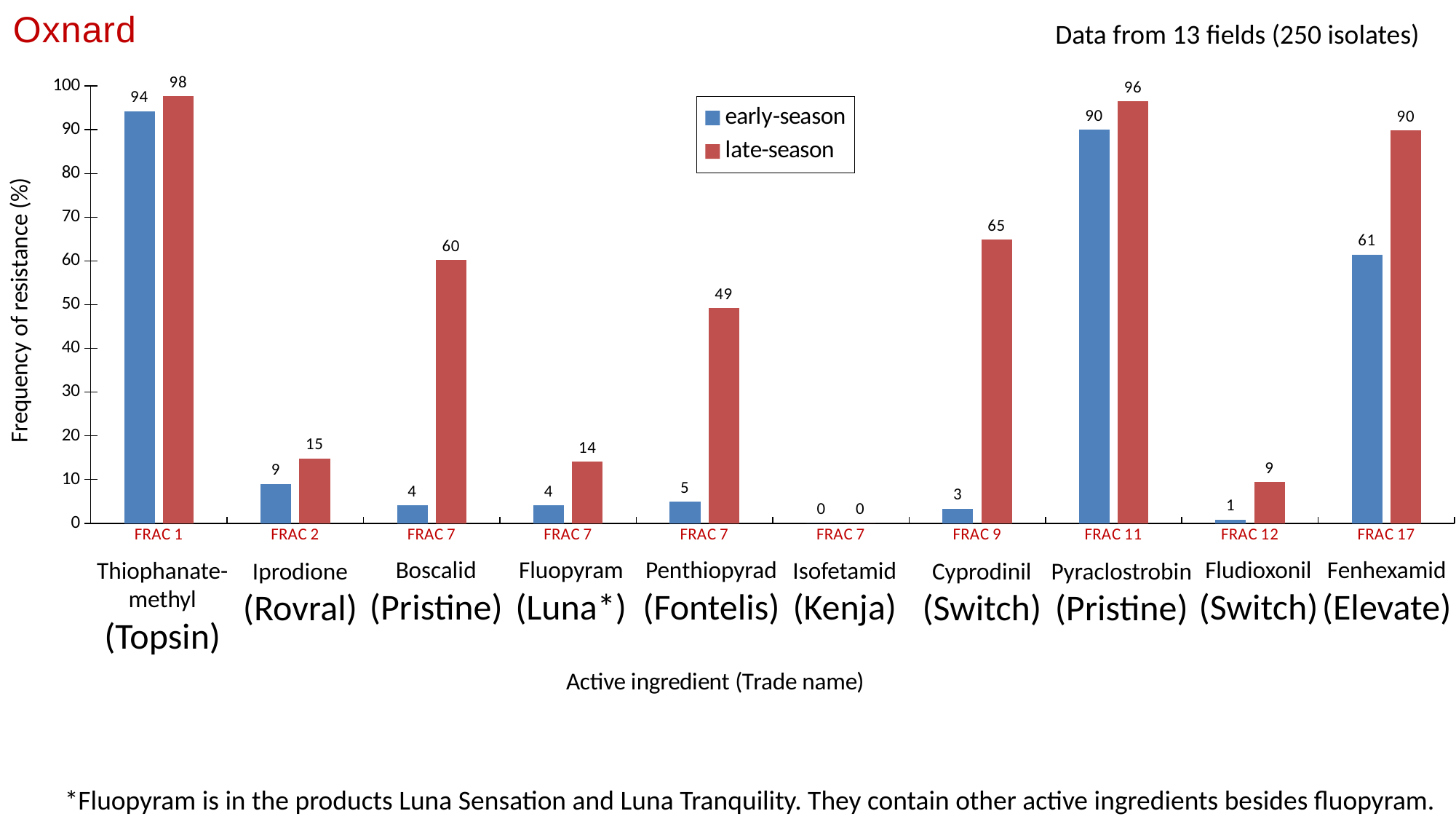
What is the difference between the late-season and early-season values for Penthiopyrad (Fontelis)? 44 Which active ingredient has the highest late-season frequency of resistance? Thiophanate-methyl (Topsin) What is the early-season value for Fludioxonil (Switch)? 1 What is the difference between the late-season and early-season values for Cyprodinil (Switch)? 62 What is the late-season frequency of resistance for Boscalid (Pristine)? 60 Which active ingredient has the lowest late-season frequency of resistance? Isofetamid (Kenja) What kind of chart is shown on the slide? bar chart What is the early-season frequency of resistance for Pyraclostrobin (Pristine)? 90 Which is larger: the late-season value for Fenhexamid (Elevate) or the late-season value for Cyprodinil (Switch)? Fenhexamid (Elevate) What is the label of the y axis? Frequency of resistance (%) How many series does the legend list? 2 How many active ingredients are shown on the x axis? 10